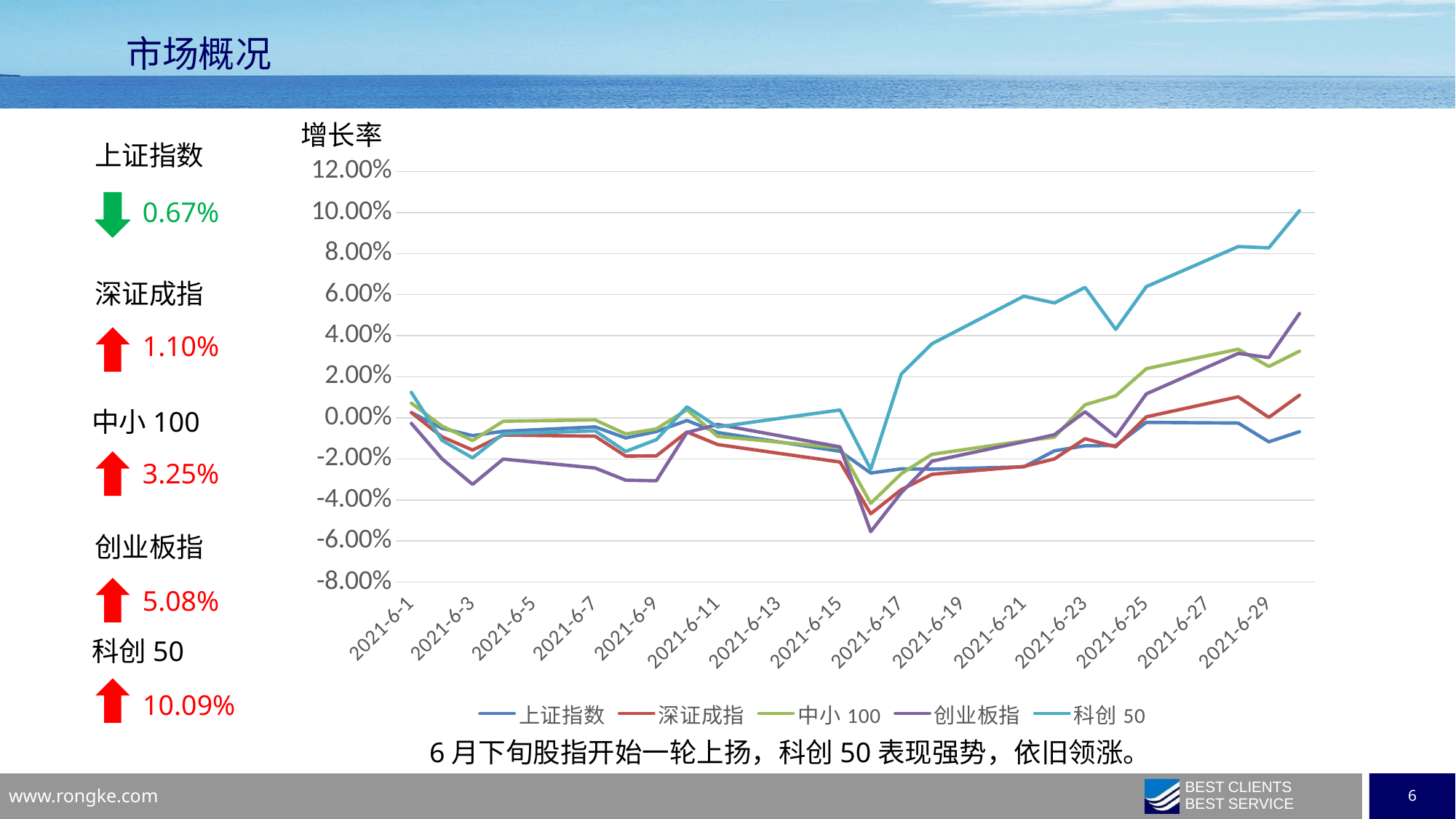
What kind of chart is shown on the slide? line chart Which series has the highest value at the right end of the chart? 科创 50 According to the summary on the left of the slide, what growth rate is shown for 科创 50? 10.09% What is the title of the chart's vertical axis? 增长率 Is the value for 科创 50 at 2021-6-29 greater or less than 8.00%? greater How many date labels are shown along the x axis of the chart? 15 Is the value for 科创 50 at 2021-6-21 greater or less than 4.00%? greater How many series does the chart legend list? 5 Does the 科创 50 line generally rise or fall from 2021-6-17 to the end of the chart? rise Which series has the lowest value around 2021-6-17? 创业板指 At 2021-6-3, which is larger: the value for 上证指数 or the value for 创业板指? 上证指数